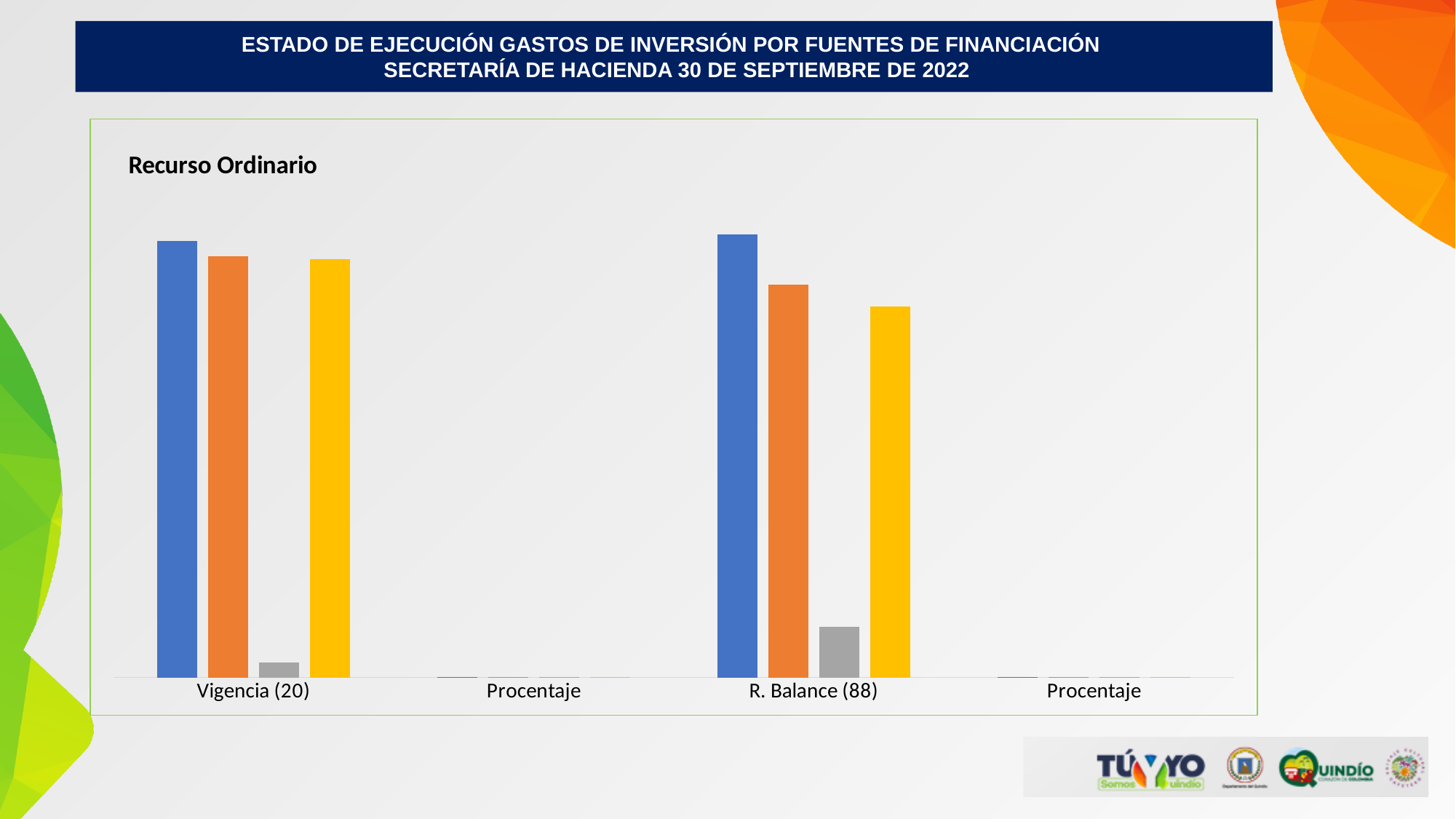
Within the Vigencia (20) category, is the yellow bar taller or shorter than the gray bar? taller How many differently coloured bars are plotted for the Vigencia (20) category? 4 Within the R. Balance (88) category, which coloured bar is the shortest? gray How many categories are shown on the x axis of the chart? 4 What is the title of the chart? Recurso Ordinario Is the blue bar taller for Vigencia (20) or for R. Balance (88)? R. Balance (88) Which categories on the x axis have bars that are barely visible above the baseline? the two Procentaje categories Within the Vigencia (20) category, which coloured bar is the shortest? gray Is the gray bar taller for Vigencia (20) or for R. Balance (88)? R. Balance (88) What kind of chart is shown on the slide? bar chart Within the R. Balance (88) category, which coloured bar is the tallest? blue